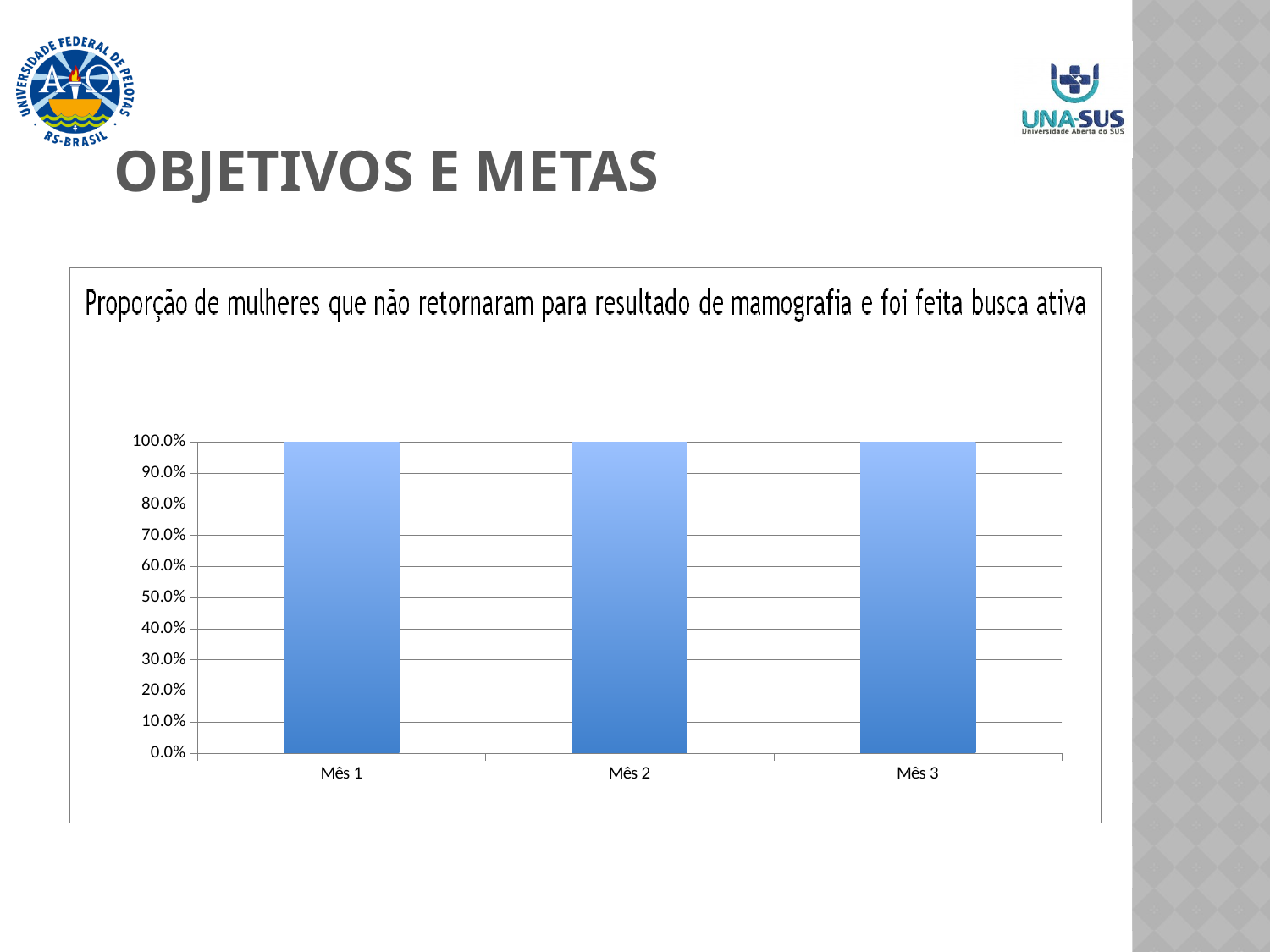
What is the label of the first category on the x axis? Mês 1 How many categories are plotted on the x axis? 3 What is the value for Mês 1? 100.0% What kind of chart is shown on the slide? bar chart What is the value for Mês 2? 100.0% Is the value for Mês 3 greater or less than 90.0%? greater What is the highest value shown on the y axis? 100.0% What is the title of the chart? Proporção de mulheres que não retornaram para resultado de mamografia e foi feita busca ativa Is the value for Mês 2 greater or less than 50.0%? greater